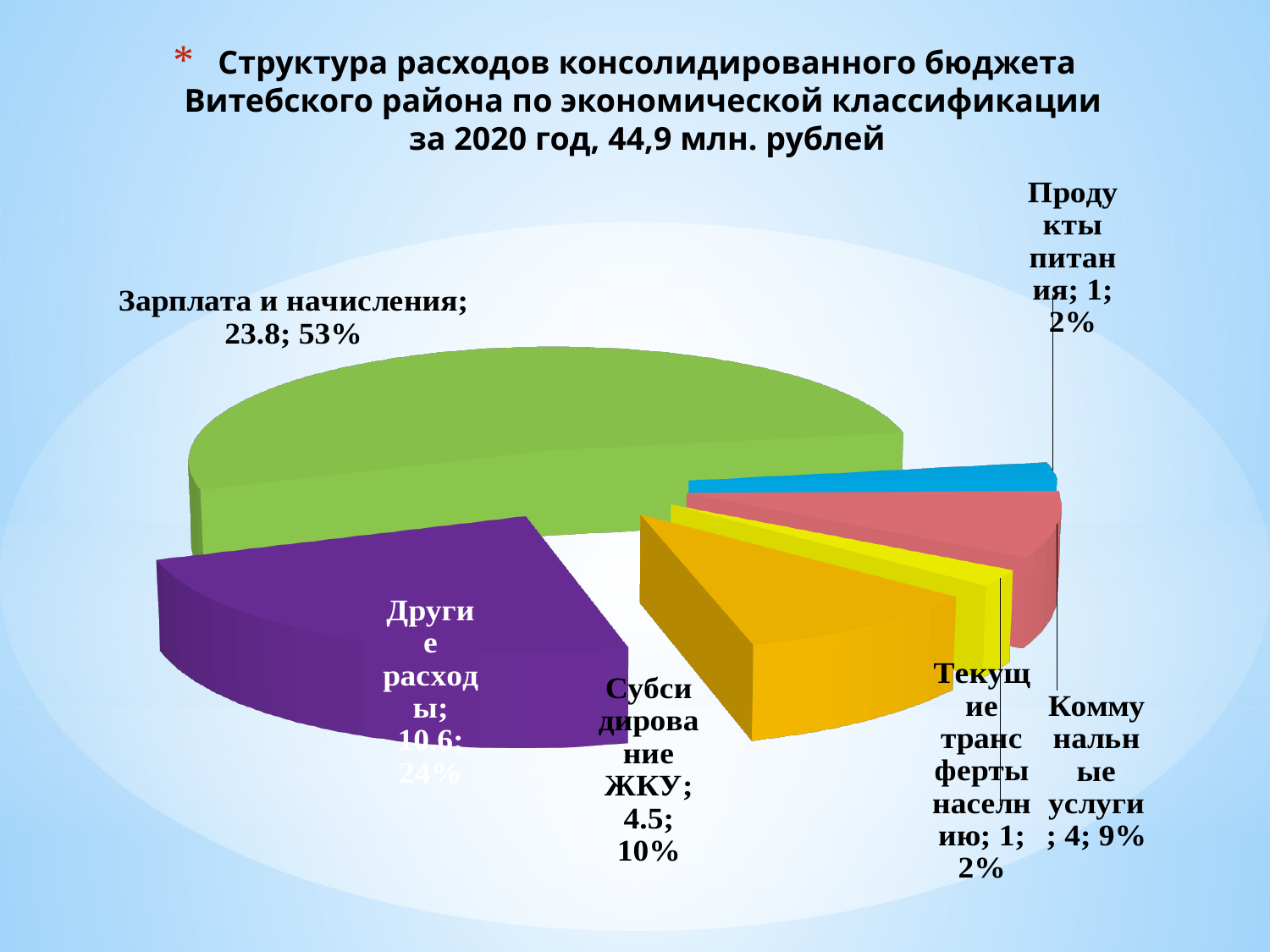
What share of the pie does Зарплата и начисления take? 53% How many slices does the pie chart have? 6 Which category has the largest slice of the pie? Зарплата и начисления What total amount in million rubles is stated in the chart title? 44,9 млн. рублей What share of the pie does Субсидирование ЖКУ take? 10% What share of the pie does Продукты питания take? 2% What is the value for Другие расходы? 10.6 What is the difference between the values for Зарплата и начисления and Другие расходы? 13.2 Which is larger, the value for Субсидирование ЖКУ or the value for Коммунальные услуги? Субсидирование ЖКУ What is the value for Коммунальные услуги? 4 What is the value for Зарплата и начисления? 23.8 What kind of chart is shown on the slide? pie chart